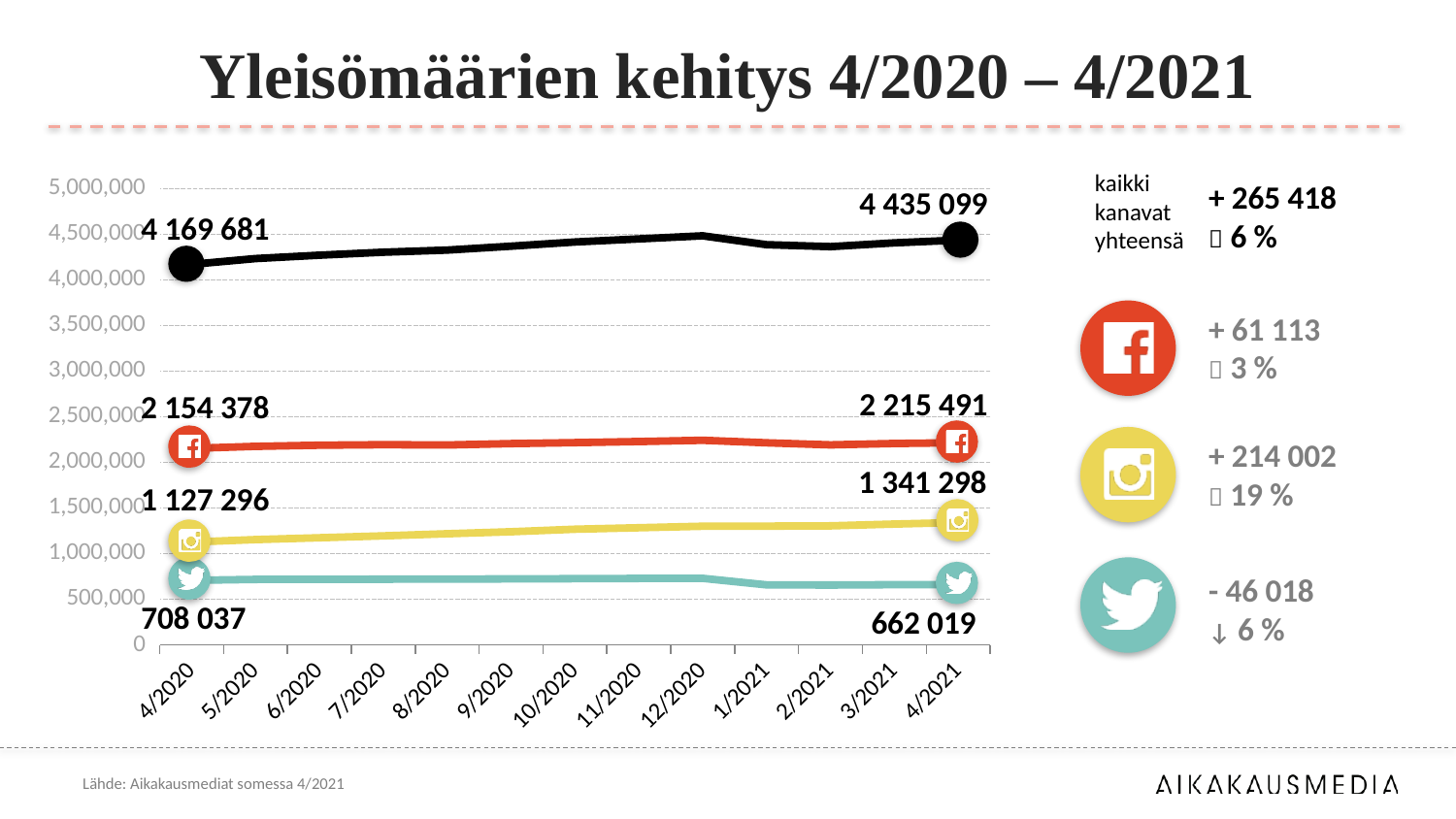
What is the value of the Instagram (yellow) line at 4/2020? 1 127 296 What is the value of the Facebook (red) line at 4/2021? 2 215 491 Does the Twitter (teal) line rise or fall from 4/2020 to 4/2021? fall What is the title of the chart on the slide? Yleisömäärien kehitys 4/2020 – 4/2021 Which line has the lowest value at 4/2021? Twitter (teal) How many time points are shown on the x axis? 13 What is the difference between the Instagram (yellow) values at 4/2021 and 4/2020? 214 002 What is the value of the black (total) line at 4/2021? 4 435 099 What is the value of the black (total) line at 4/2020? 4 169 681 What kind of chart is shown on the slide? line chart What is the value of the Twitter (teal) line at 4/2021? 662 019 Is the Facebook (red) line at 4/2020 greater or less than 2,000,000? greater